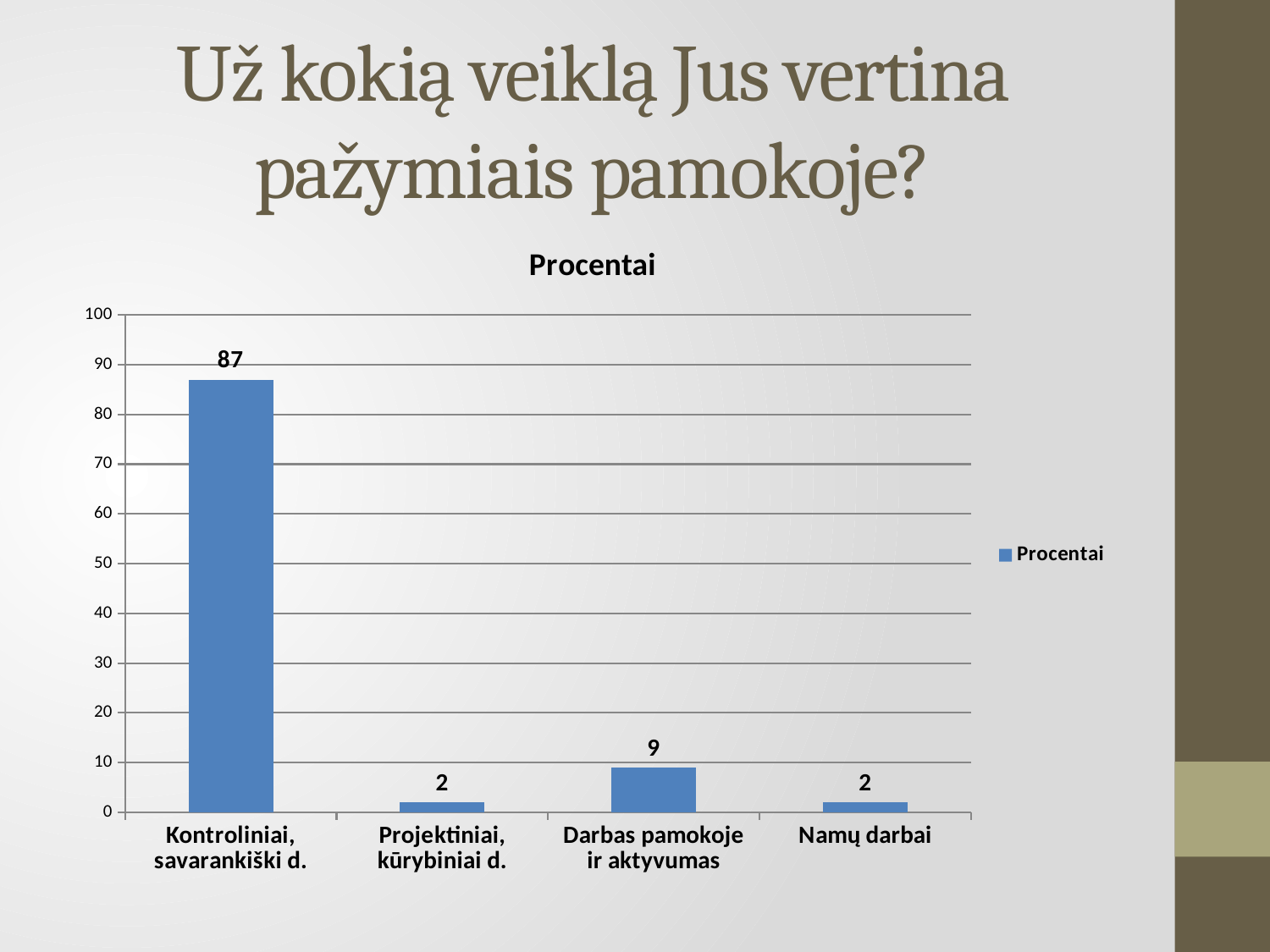
What is the value for Kontroliniai, savarankiški d.? 87 What is the difference between the values for Darbas pamokoje ir aktyvumas and Namų darbai? 7 Which is larger, the value for Darbas pamokoje ir aktyvumas or the value for Projektiniai, kūrybiniai d.? Darbas pamokoje ir aktyvumas Is the value for Kontroliniai, savarankiški d. greater or less than 80? greater What kind of chart is shown on the slide? Bar chart Which category has the highest value? Kontroliniai, savarankiški d. What is the title of the chart? Procentai How many categories are shown on the x axis? 4 What is the value for Projektiniai, kūrybiniai d.? 2 What is the value for Namų darbai? 2 What is the value for Darbas pamokoje ir aktyvumas? 9 What is the difference between the values for Kontroliniai, savarankiški d. and Darbas pamokoje ir aktyvumas? 78